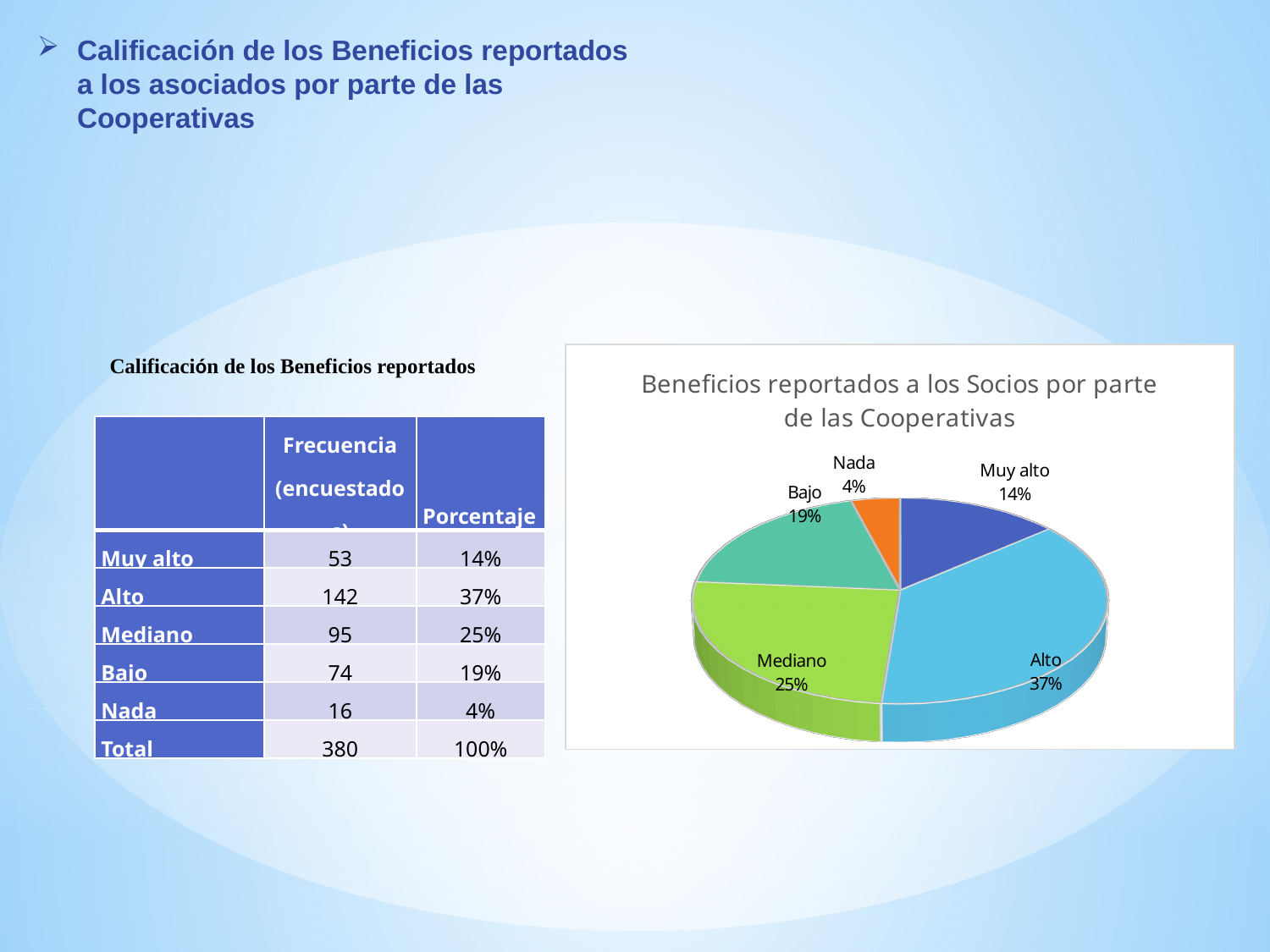
Which category has the smallest slice of the pie? Nada What percentage does the Alto slice represent? 37% What is the title of the chart? Beneficios reportados a los Socios por parte de las Cooperativas What type of chart is shown on the slide? pie chart What percentage does the Bajo slice represent? 19% What percentage does the Nada slice represent? 4% What colour is the Nada slice? orange How many slices does the pie chart have? 5 Which category has the largest slice of the pie? Alto What is the difference in percentage points between the Alto and Muy alto slices? 23 Which slice is larger, Mediano or Bajo? Mediano What percentage does the Mediano slice represent? 25%